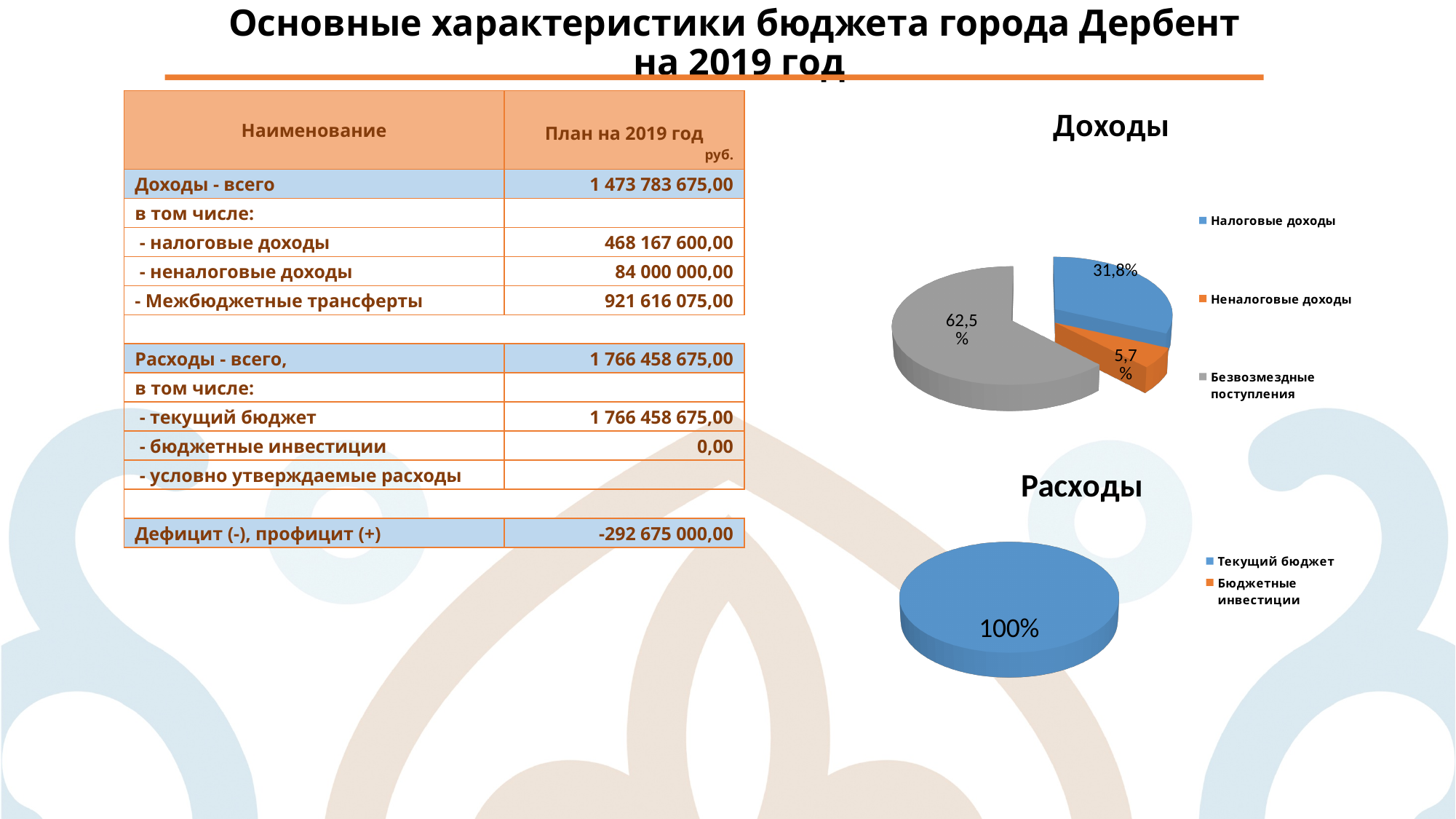
In the "Доходы" chart, what colour is the slice for Безвозмездные поступления? Grey How many entries does the legend of the "Доходы" chart list? 3 In the "Доходы" chart, what share is labelled for Безвозмездные поступления? 62,5% In the "Доходы" chart, what share is labelled for Неналоговые доходы? 5,7% In the "Доходы" chart, what share is labelled for Налоговые доходы? 31,8% In the "Расходы" chart, what share is labelled for Текущий бюджет? 100% What kind of chart is the "Доходы" chart? Pie chart In the "Доходы" chart, which category has the largest slice? Безвозмездные поступления In the "Доходы" chart, which is larger: Налоговые доходы or Неналоговые доходы? Налоговые доходы In the "Доходы" chart, which category has the smallest slice? Неналоговые доходы How many entries does the legend of the "Расходы" chart list? 2 In the "Доходы" chart, what is the difference in percentage points between Безвозмездные поступления and Налоговые доходы? 30,7